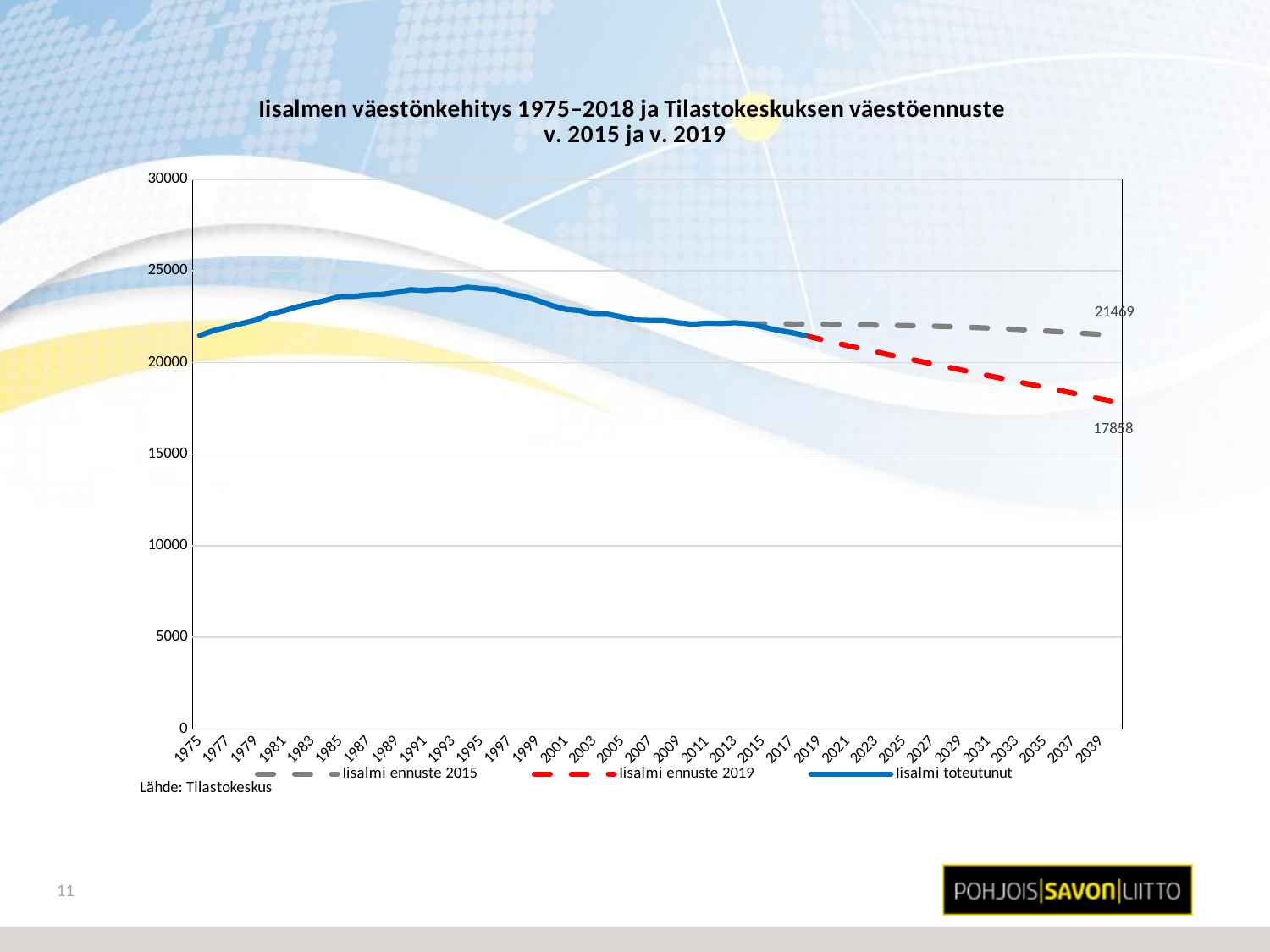
What is the value of the Iisalmi ennuste 2019 series at the end of the forecast in 2039? 17858 Does the Iisalmi ennuste 2019 series rise or fall from 2019 to 2039? fall Is the value of the Iisalmi toteutunut series in 1975 greater or less than 25000? less Which forecast series ends higher in 2039, Iisalmi ennuste 2015 or Iisalmi ennuste 2019? Iisalmi ennuste 2015 Does the Iisalmi toteutunut series rise or fall between 1995 and 2018? fall What is the difference between the 2015 forecast and the 2019 forecast values for 2039? 3611 What is the title of the chart? Iisalmen väestönkehitys 1975–2018 ja Tilastokeskuksen väestöennuste v. 2015 ja v. 2019 Is the value of the Iisalmi toteutunut series in 1995 greater or less than 20000? greater What kind of chart is shown on the slide? line chart How many series does the legend list? 3 What is the value of the Iisalmi ennuste 2015 series at the end of the forecast in 2039? 21469 What colour is the Iisalmi toteutunut line? blue